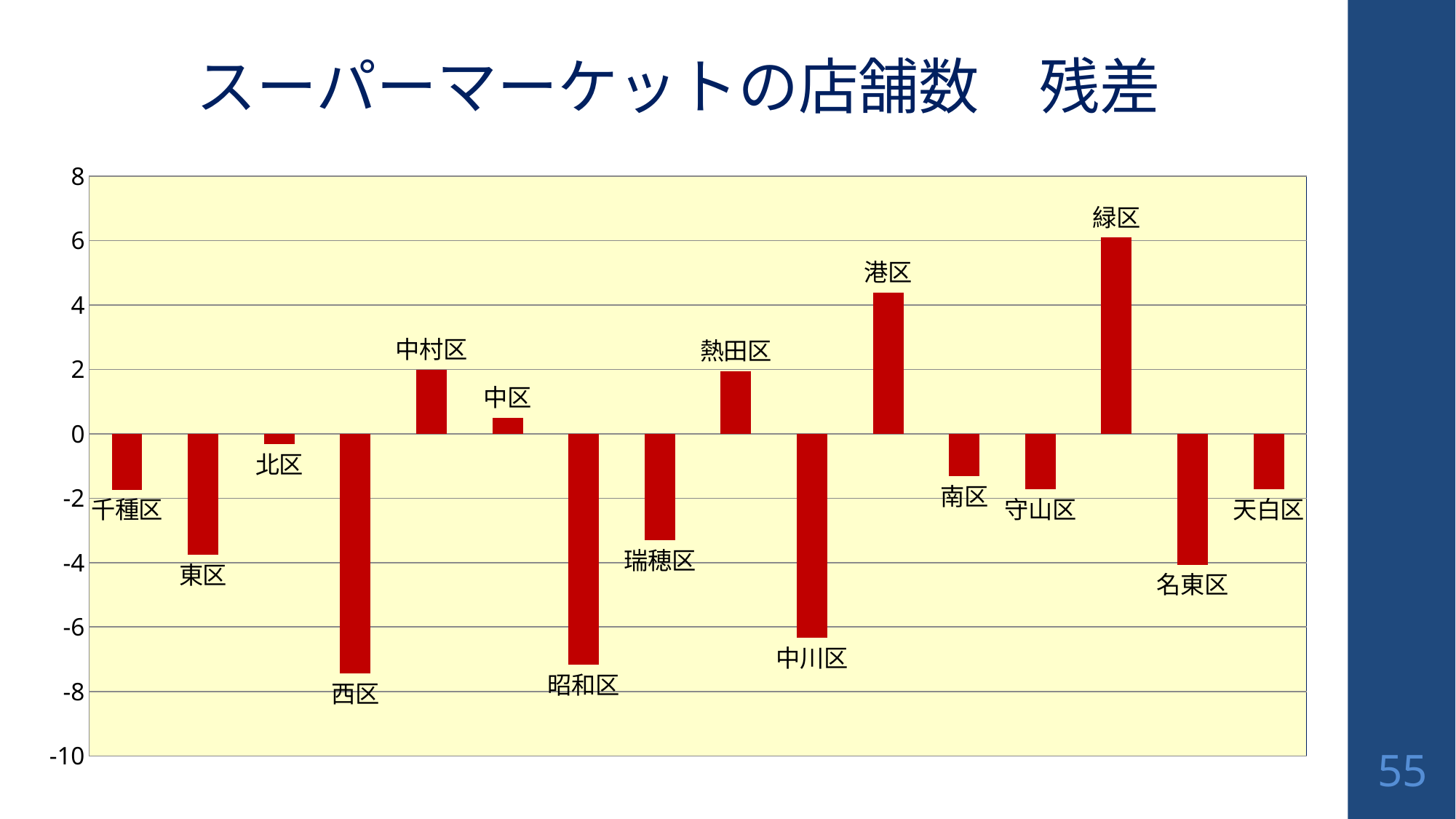
Is the value for 東区 greater or less than -2? less Is the value for 西区 greater or less than -6? less Which is larger, the value for 緑区 or the value for 港区? 緑区 Is the value for 港区 greater or less than 2? greater How many wards (categories) are plotted in the chart? 16 What is the title of the chart? スーパーマーケットの店舗数 残差 What colour are the bars in the chart? red What kind of chart is shown on the slide? bar chart Which is larger, the value for 千種区 or the value for 東区? 千種区 Which ward has the highest value in the chart? 緑区